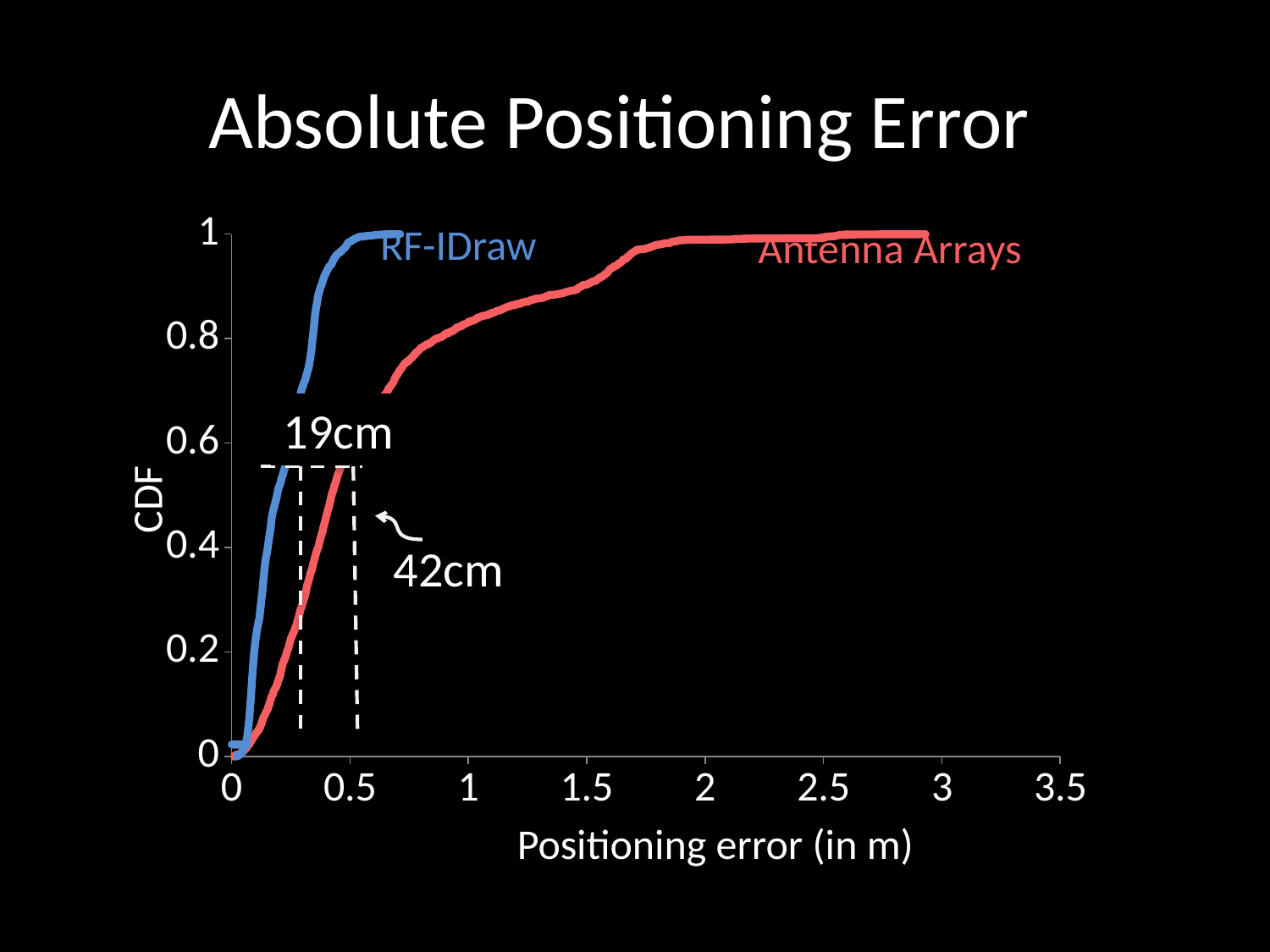
What positioning error is annotated for the RF-IDraw curve? 19cm What is the label of the x axis? Positioning error (in m) What positioning error is annotated for the Antenna Arrays curve? 42cm What is the difference between the two annotated positioning errors? 23cm Which series has the larger annotated positioning error, RF-IDraw or Antenna Arrays? Antenna Arrays Do the CDF curves rise or fall as positioning error increases along the x axis? Rise Which series reaches a CDF of 1 at a smaller positioning error, RF-IDraw or Antenna Arrays? RF-IDraw What is the title of the chart? Absolute Positioning Error What kind of chart is shown on the slide? Line chart At a positioning error of 1.5 m, is the CDF for Antenna Arrays greater or less than 0.8? greater At a positioning error of 0.5 m, is the CDF for Antenna Arrays greater or less than 0.8? less How many series are plotted in the chart? 2